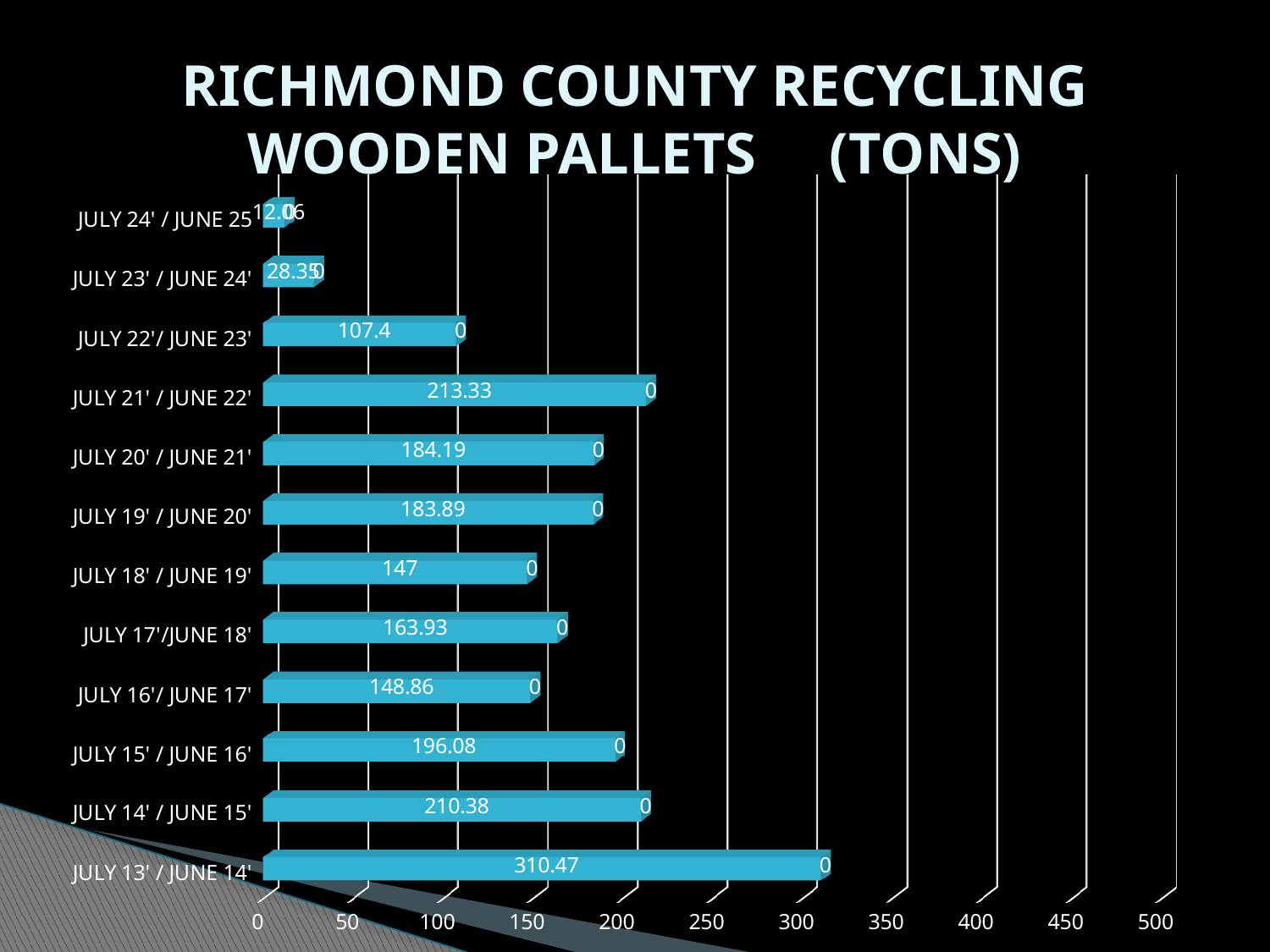
What is the value for JULY 21' / JUNE 22'? 213.33 What is the value for JULY 13' / JUNE 14'? 310.47 Which period has the lowest value? JULY 24' / JUNE 25 What is the value for JULY 18' / JUNE 19'? 147 What is the title of the chart? RICHMOND COUNTY RECYCLING WOODEN PALLETS (TONS) What is the difference between the values for JULY 13' / JUNE 14' and JULY 14' / JUNE 15'? 100.09 Which period has the highest value? JULY 13' / JUNE 14' Which is larger, the value for JULY 15' / JUNE 16' or the value for JULY 16' / JUNE 17'? JULY 15' / JUNE 16' What type of chart is shown on the slide? bar chart How many periods are shown on the chart? 12 What is the value for JULY 23' / JUNE 24'? 28.35 Is the value for JULY 22' / JUNE 23' greater or less than 150? less